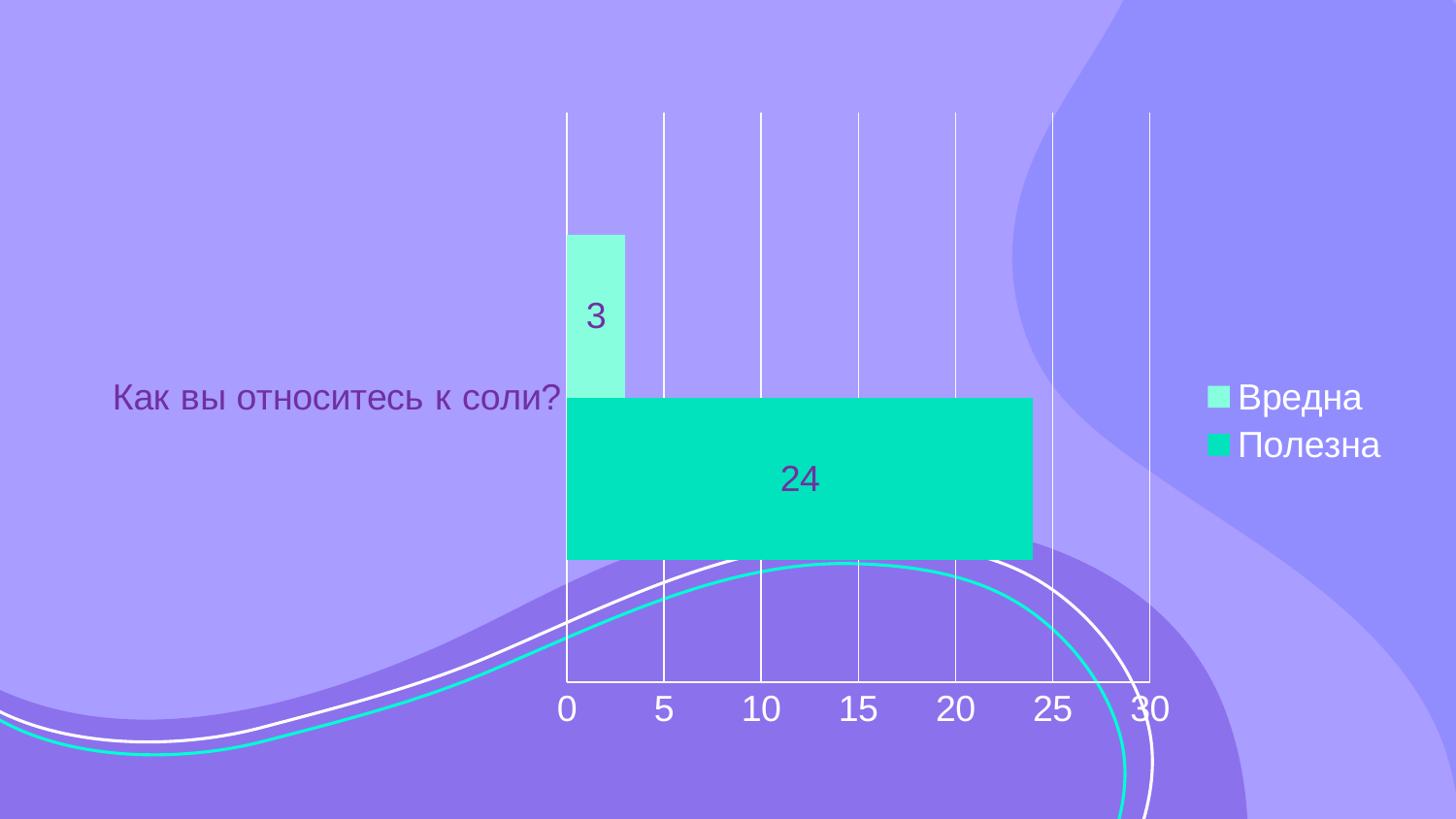
How many series does the legend list? 2 Is the value for "Вредна" greater or less than 5? less What is the maximum value shown on the horizontal axis? 30 Which series has the higher value, "Вредна" or "Полезна"? Полезна What kind of chart is shown on the slide? Bar chart Which series has the lowest value? Вредна What is the value for "Полезна"? 24 Is the value for "Полезна" greater or less than 20? greater What is the value for "Вредна"? 3 What is the difference between the values for "Полезна" and "Вредна"? 21 What is the category label shown on the chart? Как вы относитесь к соли? Which series has the highest value? Полезна